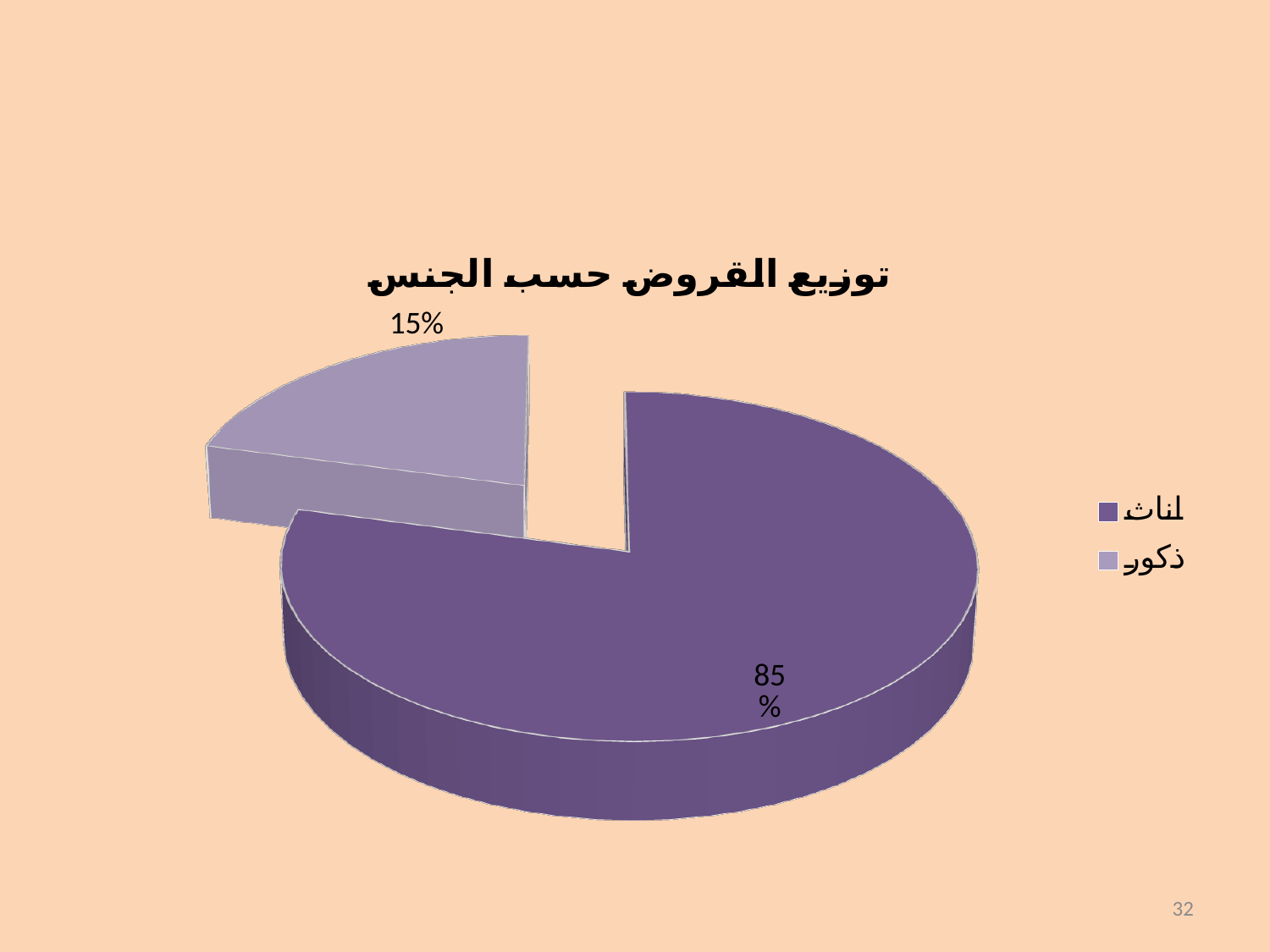
Which category has the smallest slice of the pie? ذكور Which slice is larger, إناث or ذكور? إناث What kind of chart is shown on the slide? pie chart What is the difference in percentage points between the إناث slice and the ذكور slice? 70 Which category has the largest slice of the pie? إناث How many slices does the pie chart have? 2 What is the title of the chart? توزيع القروض حسب الجنس How many entries does the legend list? 2 What share of the pie does ذكور (males) hold? 15% Which legend entry is shown in the lighter purple colour? ذكور What share of the pie does إناث (females) hold? 85%